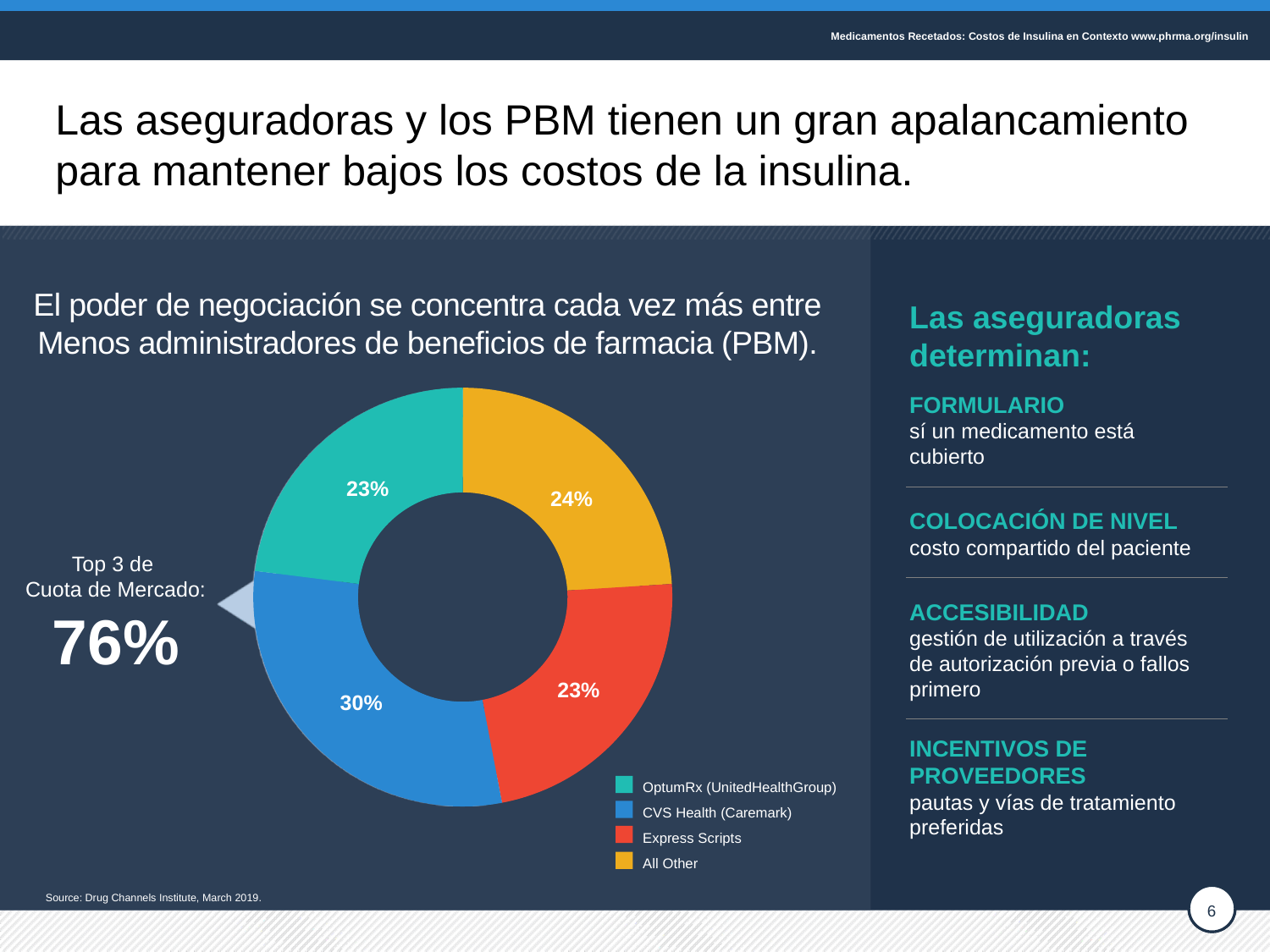
Which colour represents Express Scripts in the pie chart? Red Which has a larger market share, CVS Health (Caremark) or All Other? CVS Health (Caremark) What share of the market does CVS Health (Caremark) hold in the pie chart? 30% Which PBM has the largest market share in the pie chart? CVS Health (Caremark) What share of the market does Express Scripts hold in the pie chart? 23% What share of the market does OptumRx (UnitedHealthGroup) hold in the pie chart? 23% How many entries does the chart legend list? 4 What is the combined market share of the top 3 PBMs shown on the slide? 76% How many slices does the pie chart have? 4 What type of chart is shown on the slide? Pie chart (donut) What is the difference in market share between CVS Health (Caremark) and All Other? 6 percentage points What share of the market is labelled All Other in the pie chart? 24%